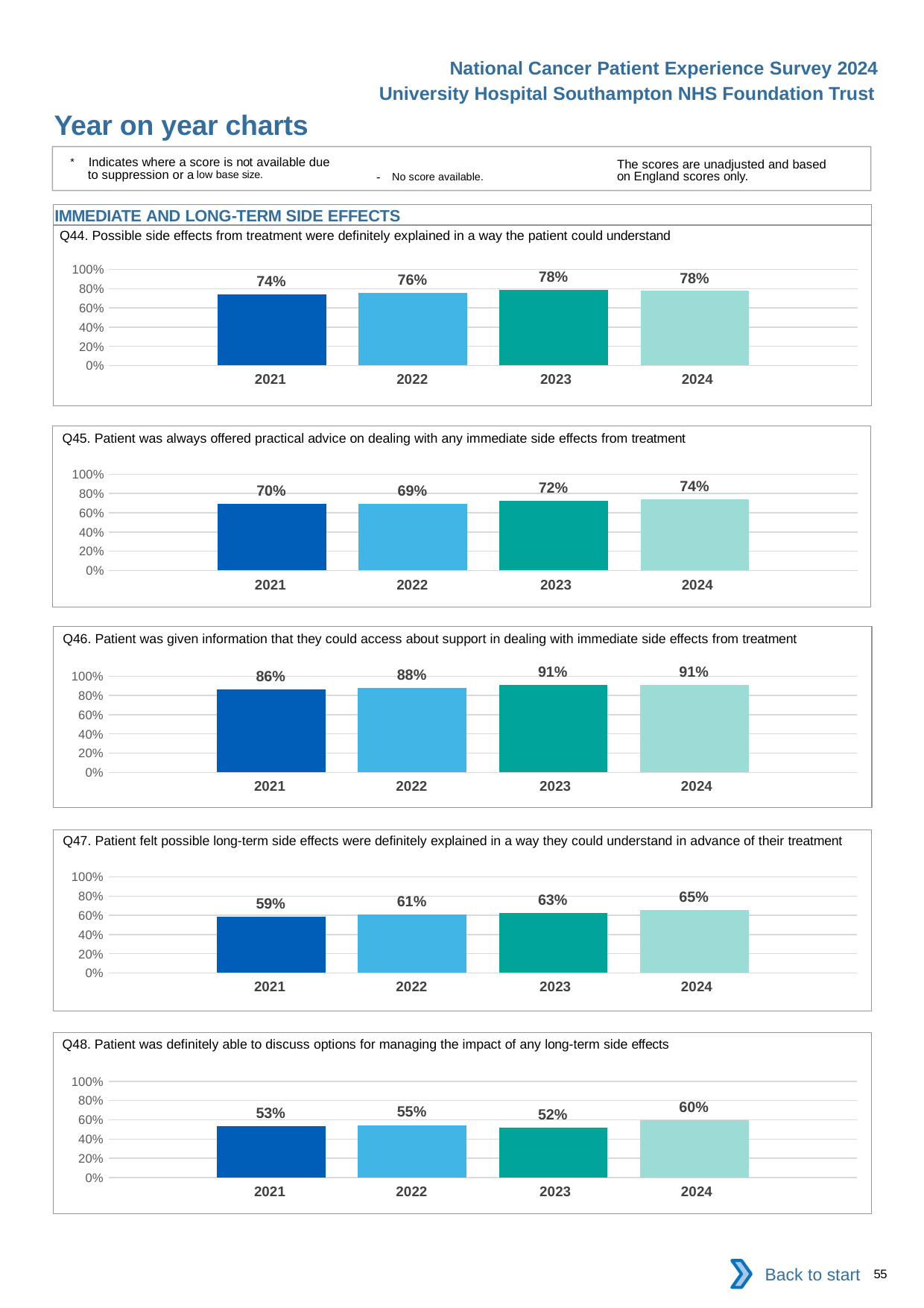
In the Q45 chart, what is the difference between the 2024 and 2021 values? 4% In the Q44 chart, is the value for 2022 greater or less than 80%? less In the Q47 chart, do the values rise or fall from 2021 to 2024? rise In the Q48 chart, which is larger, the value for 2022 or the value for 2023? 2022 In the Q45 chart, which year has the lowest value? 2022 What kind of chart is the Q46 chart? bar chart In the Q47 chart, which year has the highest value? 2024 How many years are shown in the Q45 chart? 4 In the Q48 chart, what is the value for 2024? 60% In the Q44 chart, what is the value for 2021? 74% In the Q46 chart, what is the difference between the 2023 and 2021 values? 5% What is the section heading above the Q44 chart? IMMEDIATE AND LONG-TERM SIDE EFFECTS